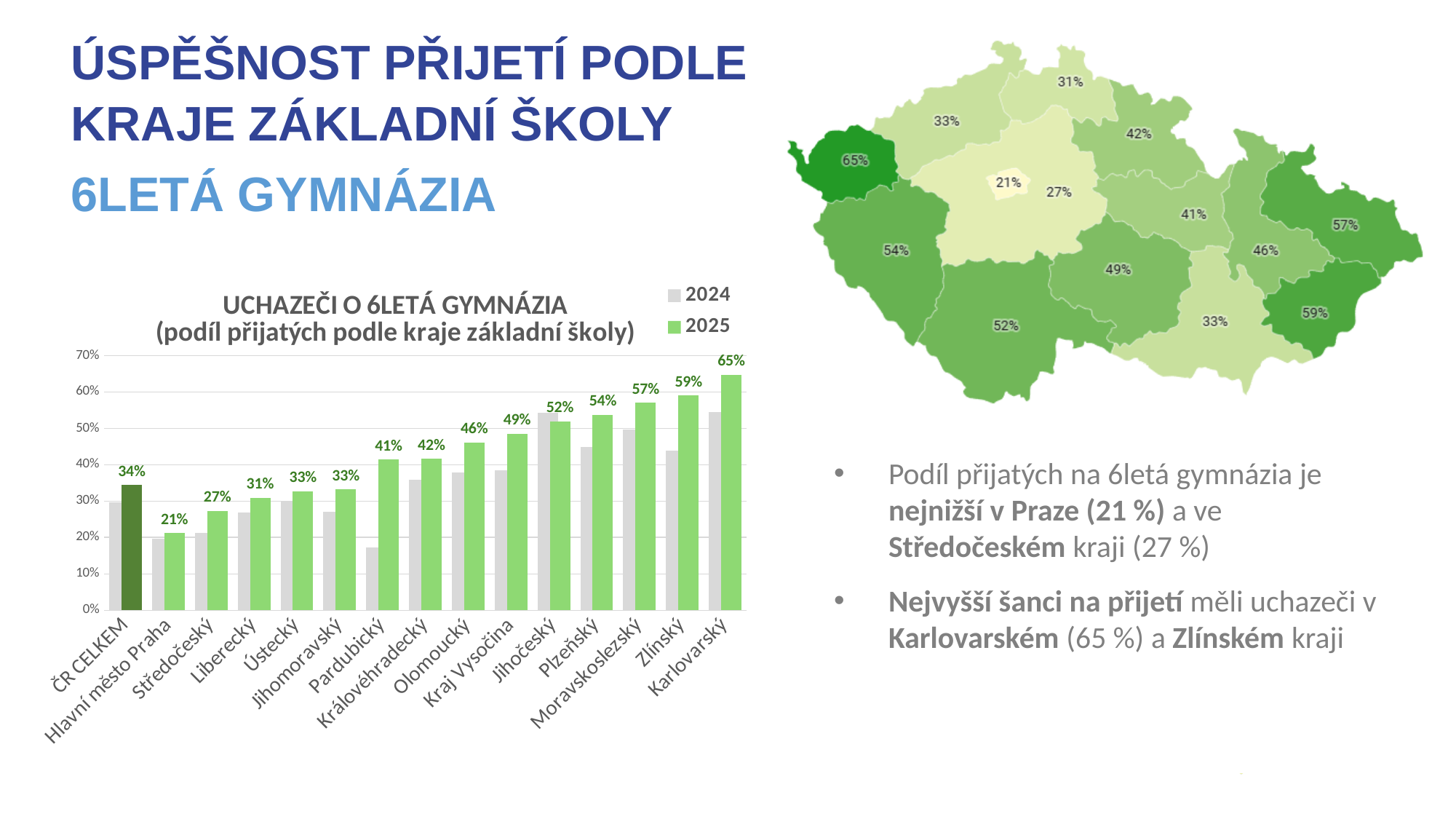
What is the 2025 value for Hlavní město Praha in the bar chart? 21% What is the 2025 value for Olomoucký in the bar chart? 46% What is the 2025 value for Karlovarský in the bar chart? 65% What type of chart is shown on the left of the slide? bar chart Which region has the lowest 2025 value in the bar chart? Hlavní město Praha Which has a larger 2025 value in the bar chart, Plzeňský or Jihočeský? Plzeňský What is the 2025 value for ČR CELKEM in the bar chart? 34% Which region has the highest 2025 value in the bar chart? Karlovarský How many series does the legend of the bar chart list? 2 What is the difference between the 2025 values for Karlovarský and Hlavní město Praha? 44% How many categories are shown on the x axis of the bar chart? 15 Is the 2024 value for Pardubický in the bar chart greater or less than 20%? less